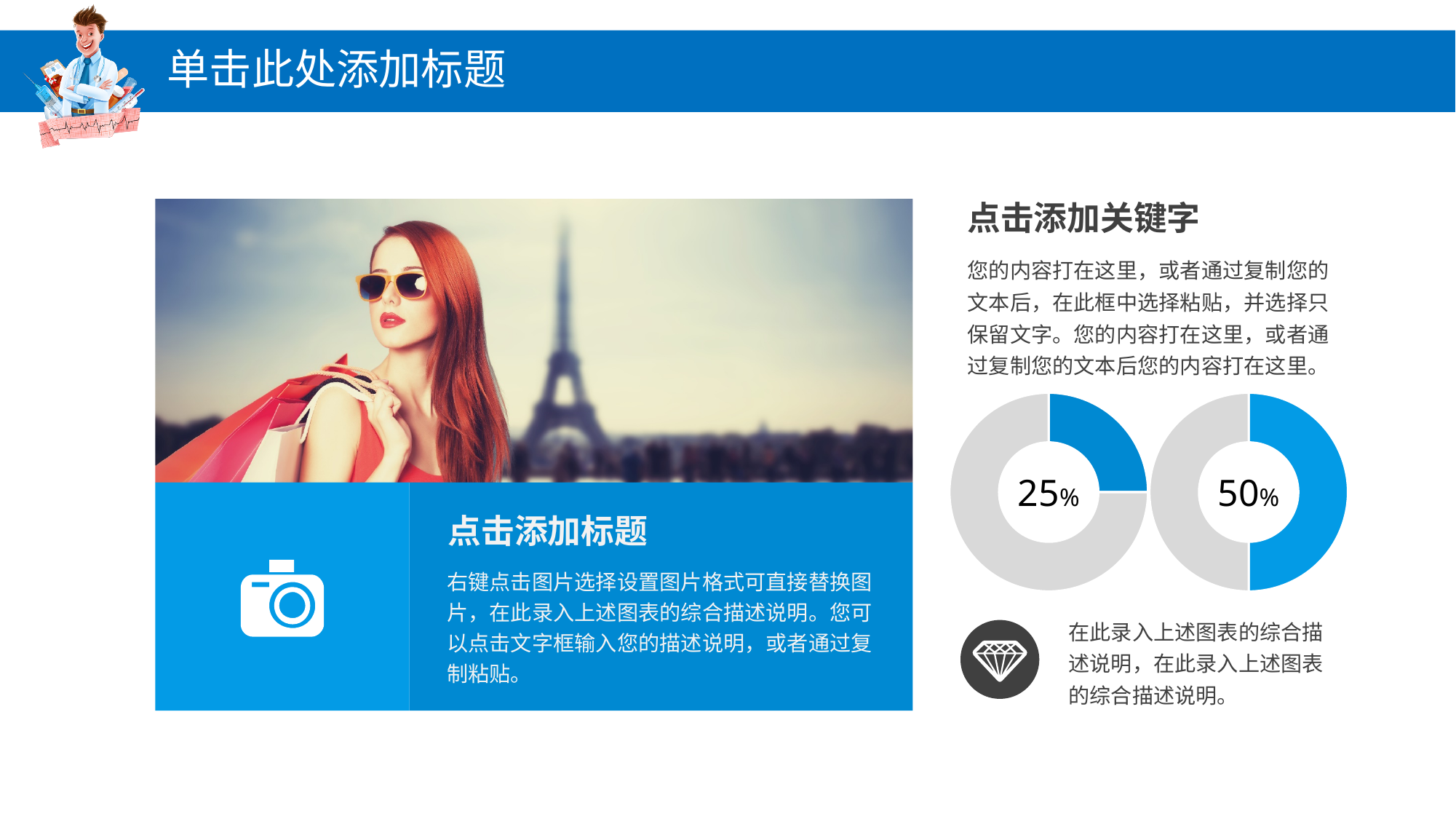
What kind of chart is used to display the 25% and 50% values? donut chart How many donut charts are shown on the slide? 2 In the left donut chart, what share of the ring is filled in blue? 25% Is the value shown in the left donut chart greater or less than 50%? less What colour is the unfilled remainder of each donut ring? grey What is the difference between the percentage in the right donut chart and the percentage in the left donut chart? 25% In the right donut chart, what share of the ring is filled in blue? 50% What value is shown in the centre of the left donut chart? 25% What colour is used for the filled portion of each donut chart? blue Which donut chart shows the larger percentage, the left one or the right one? the right one What value is shown in the centre of the right donut chart? 50%